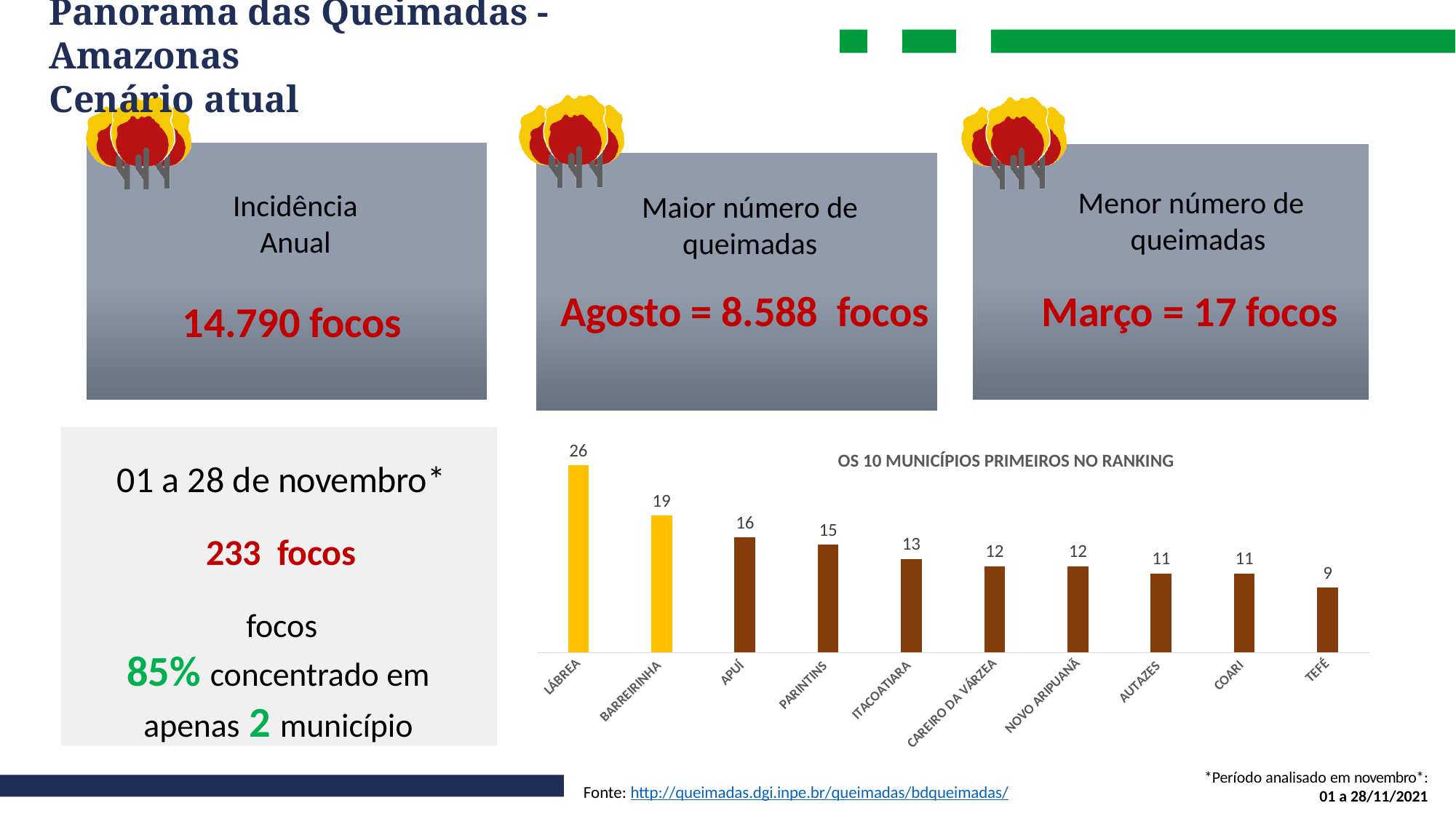
What is the value for Lábrea in the chart? 26 What is the difference between the values for Lábrea and Barreirinha? 7 What is the difference between the values for Apuí and Itacoatiara? 3 What is the value for Tefé in the chart? 9 What is the value for Parintins in the chart? 15 Which municipality has the highest value in the chart? Lábrea Do the values rise or fall from left to right across the chart? Fall How many municipalities are shown in the chart? 10 Which municipality has the lowest value in the chart? Tefé What is the title of the chart? OS 10 MUNICÍPIOS PRIMEIROS NO RANKING Which is larger, the value for Barreirinha or the value for Apuí? Barreirinha What kind of chart is shown on the slide? Bar chart